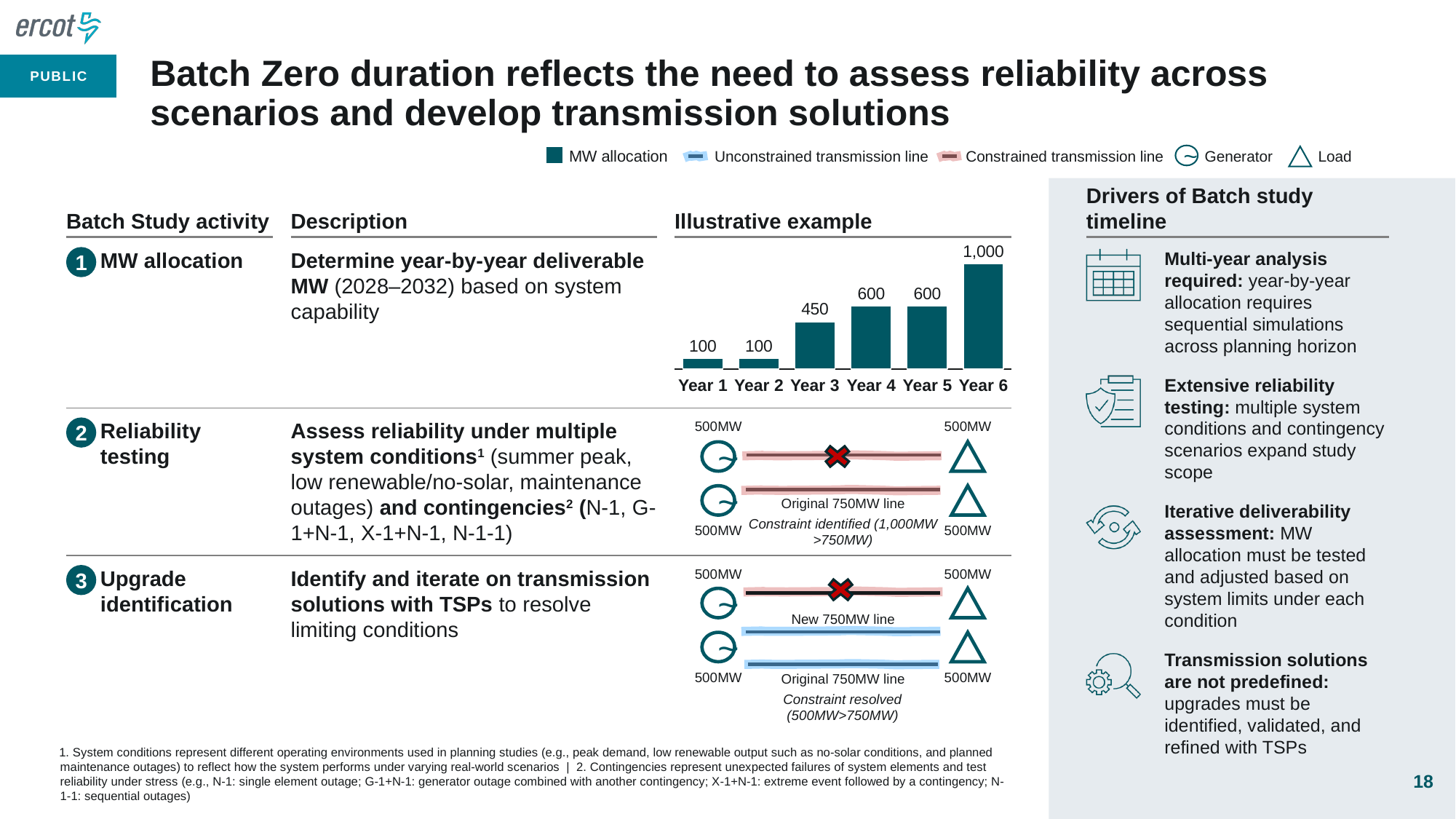
In the MW allocation bar chart, which year has the highest value? Year 6 How many years are shown in the MW allocation bar chart? 6 In the MW allocation bar chart, what is the total of the values for Year 4 and Year 5? 1,200 In the MW allocation bar chart, what is the difference between Year 6 and Year 5? 400 What kind of chart is used for the MW allocation illustrative example? Bar chart In the MW allocation bar chart, what is the value for Year 1? 100 In the MW allocation bar chart, do the values generally rise or fall from Year 1 to Year 6? Rise In the MW allocation bar chart, what is the difference between Year 3 and Year 2? 350 In the MW allocation bar chart, what is the value for Year 3? 450 In the MW allocation bar chart, which is larger, the value for Year 4 or the value for Year 3? Year 4 In the MW allocation bar chart, what is the value for Year 6? 1,000 In the MW allocation bar chart, which two years share the lowest value? Year 1 and Year 2